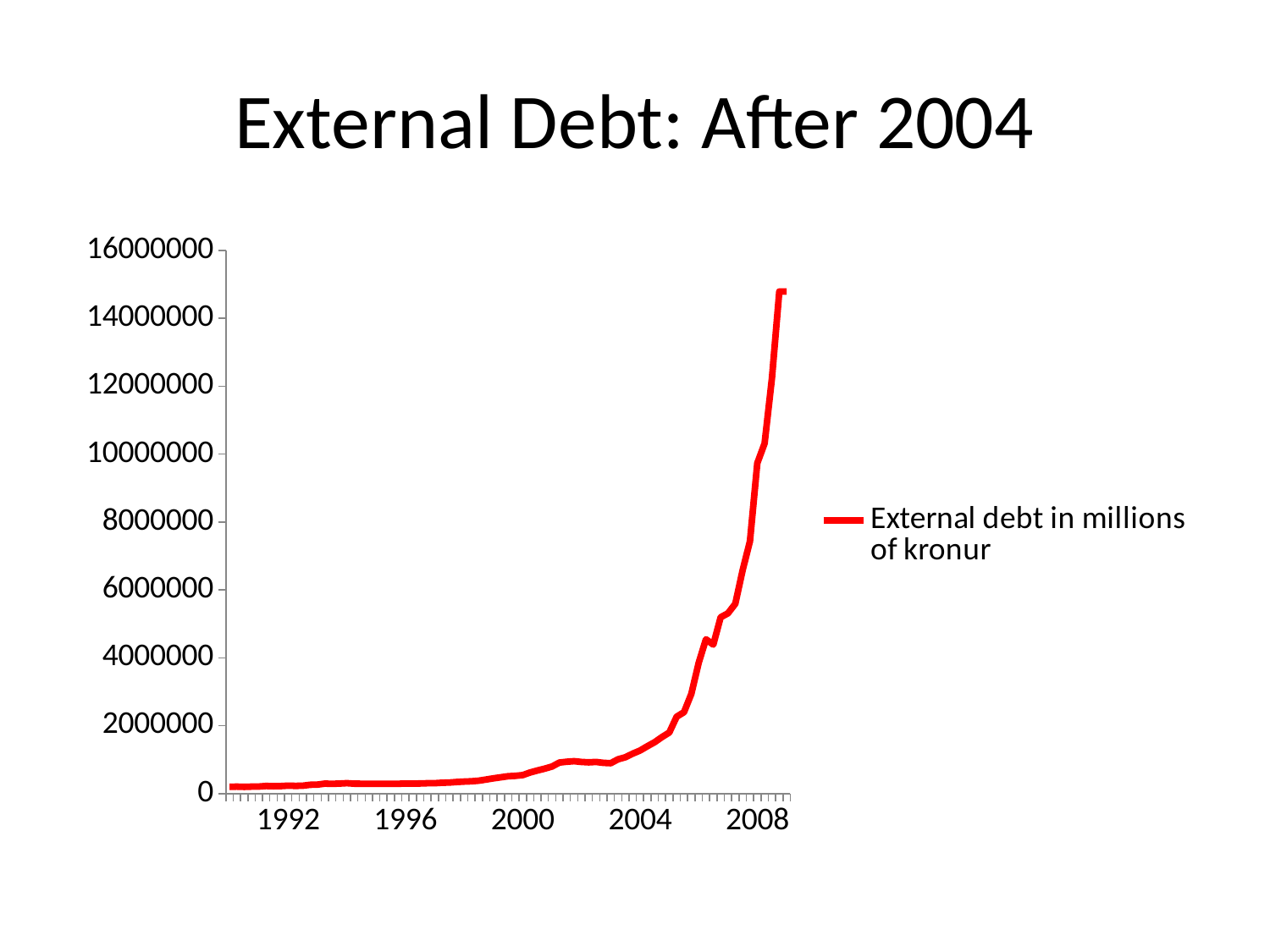
Is the value for 2000 greater or less than 2000000? less What kind of chart is shown on the slide? line chart What is the highest tick value shown on the y axis? 16000000 Is the value for 1996 greater or less than 2000000? less Which is larger, the value for 2008 or the value for 2004? 2008 Do the values generally rise or fall along the x axis from 1992 to 2008? rise Is the value for 2004 greater or less than 2000000? less What series name is shown in the legend? External debt in millions of kronur What is the title of the chart? External Debt: After 2004 How many series does the legend list? 1